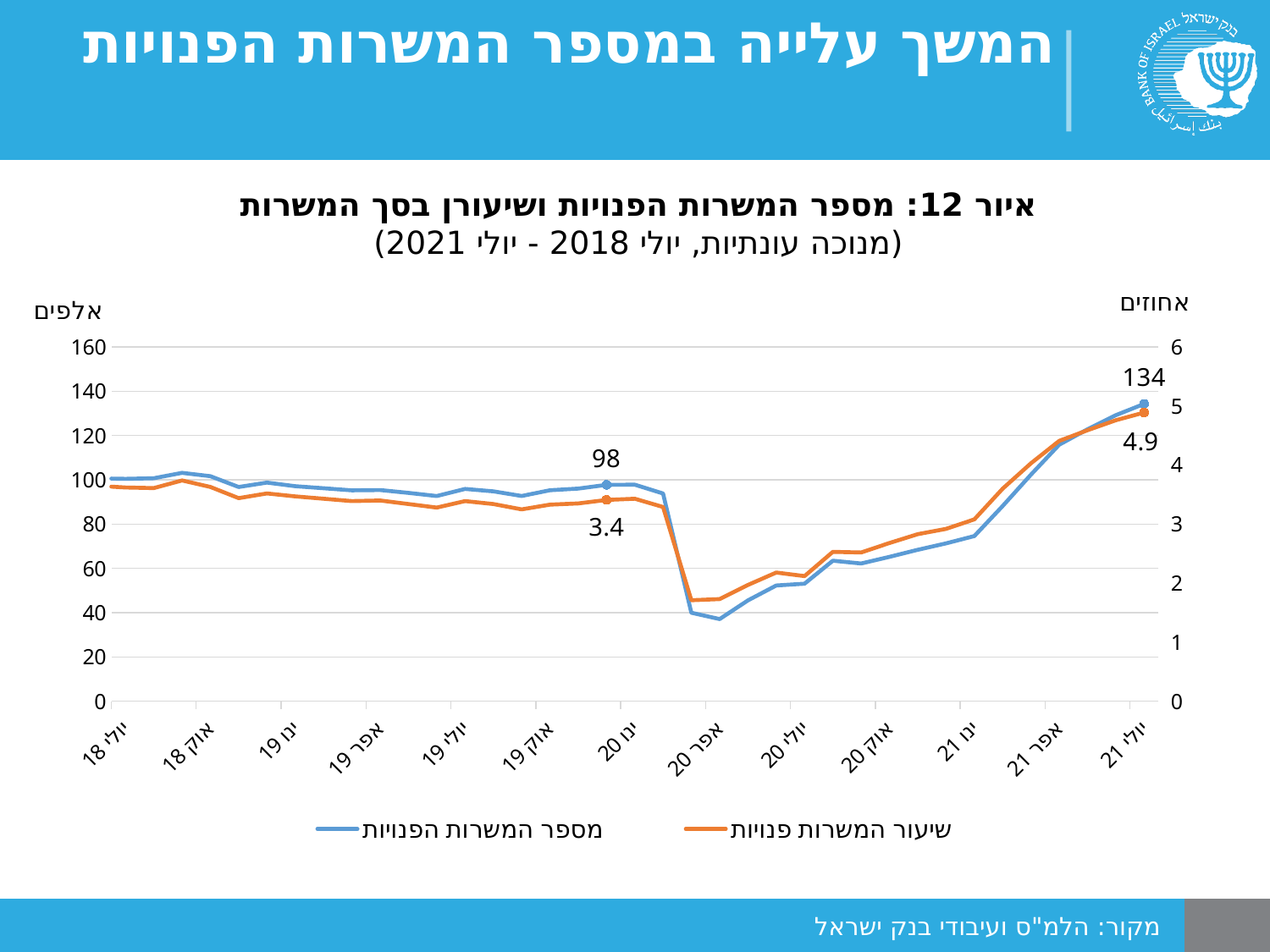
What is the labelled value of the vacancy rate (שיעור המשרות פנויות) in יולי 21? 4.9 Does the number of vacant jobs rise or fall between אפר 20 and יולי 21? rise What is the labelled value of the vacancy rate (שיעור המשרות פנויות) in ינו 20? 3.4 By how much did the labelled number of vacant jobs increase from ינו 20 to יולי 21? 36 What kind of chart is shown on the slide? Line chart What is the labelled value of the number of vacant jobs (מספר המשרות הפנויות) in ינו 20? 98 What is the labelled value of the number of vacant jobs (מספר המשרות הפנויות) in יולי 21? 134 Is the number of vacant jobs (blue line) in אפר 20 greater or less than 60? less How many series does the legend list? 2 At which x-axis date does the number of vacant jobs (blue line) reach its highest value? יולי 21 Is the vacancy rate (orange line) in אפר 20 greater or less than 2? less What is the unit label shown above the left axis? אלפים